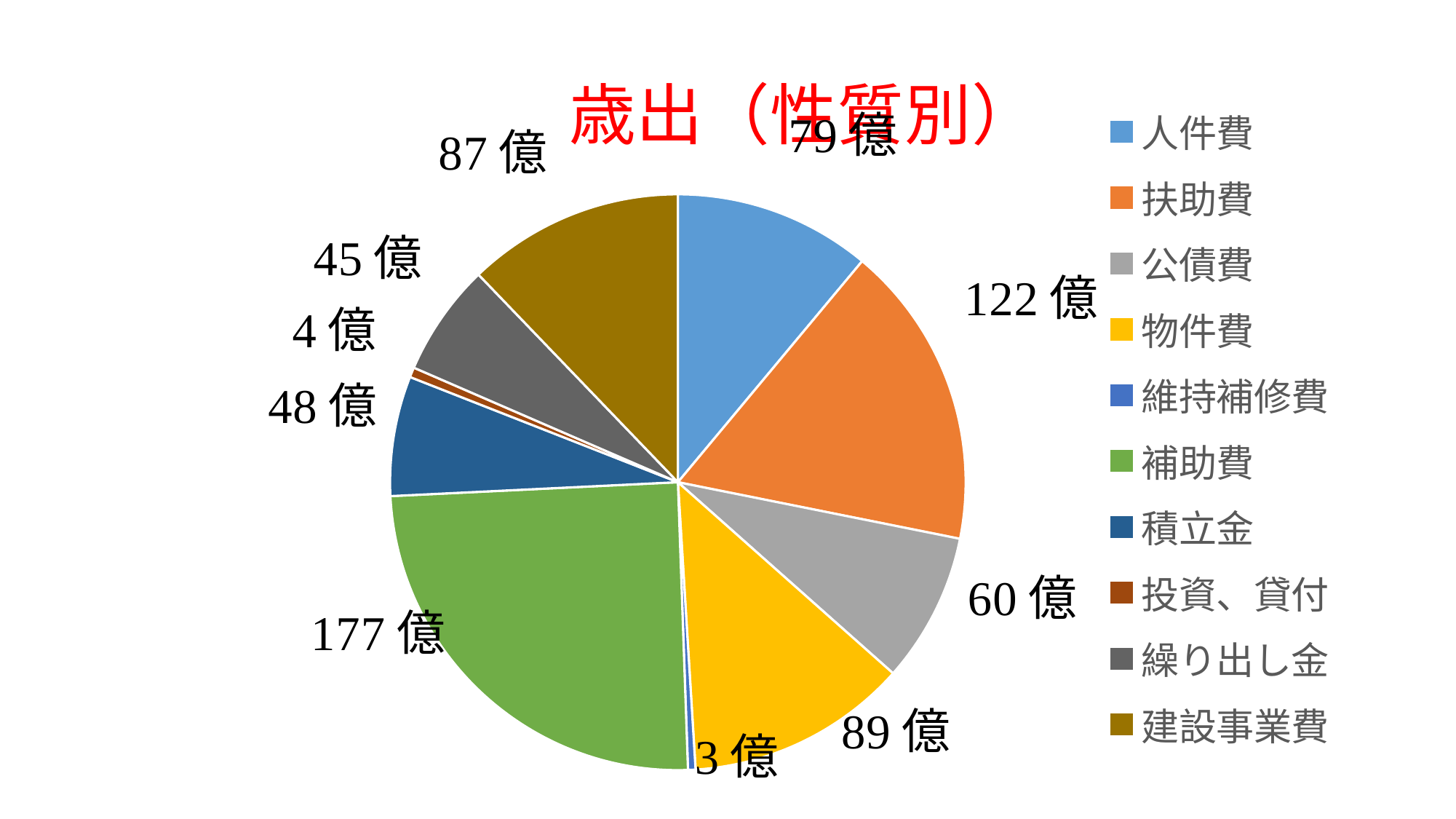
What kind of chart is shown on the slide? pie chart What colour is the slice for 建設事業費? dark gold (olive brown) Which category has the smallest value? 維持補修費 Which is larger, the value for 人件費 or the value for 公債費? 人件費 What is the difference between the values for 補助費 and 扶助費? 55 億 What is the value for 補助費? 177 億 What is the value for 維持補修費? 3 億 Which category has the largest value? 補助費 How many categories does the legend list? 10 What is the title of the chart? 歳出（性質別） What is the value for 物件費? 89 億 What is the value for 扶助費? 122 億